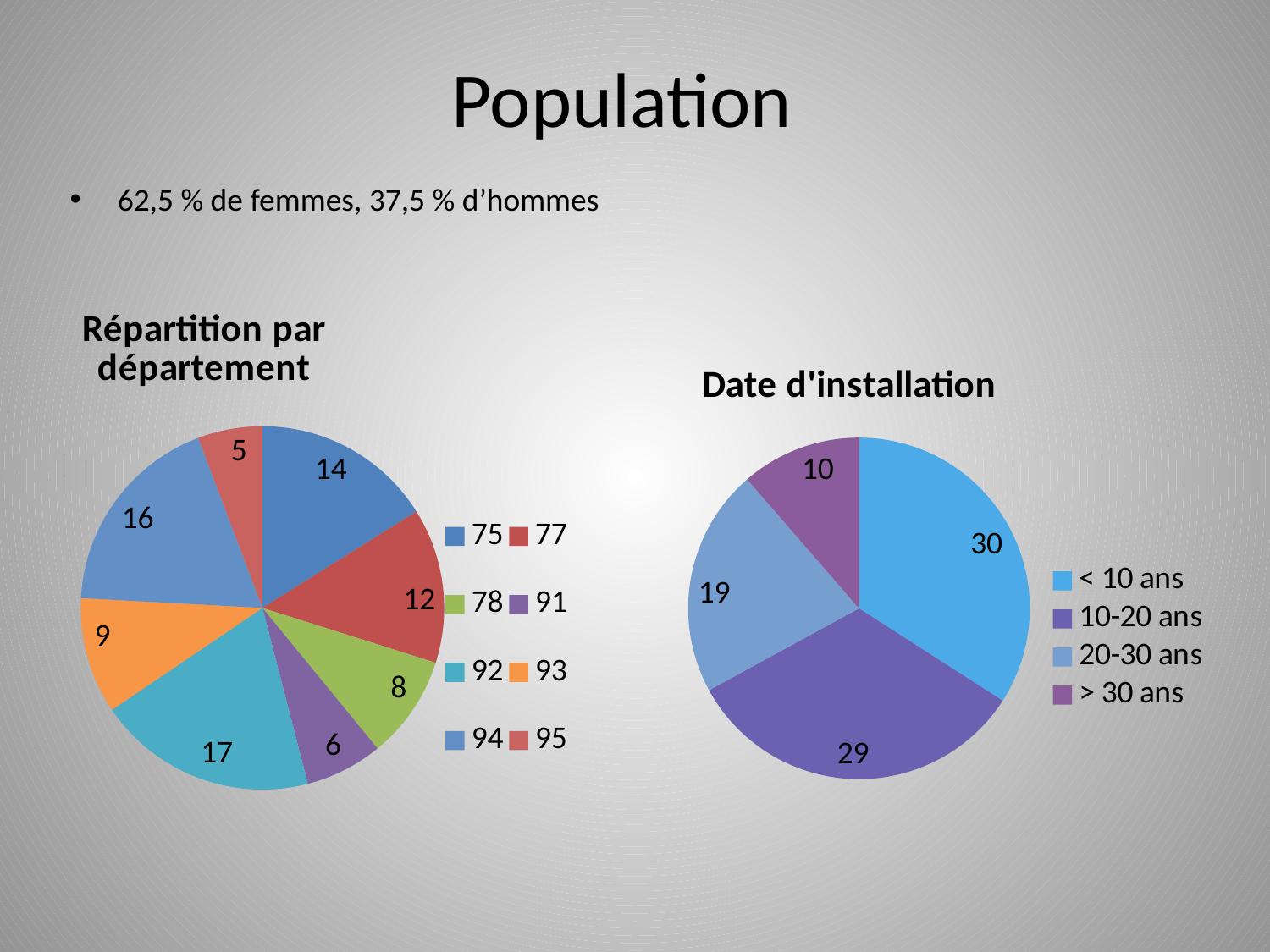
In the 'Répartition par département' chart, which département has the largest slice? 92 In the 'Répartition par département' chart, what is the value for département 95? 5 What type of chart is the 'Date d'installation' chart? Pie chart In the 'Date d'installation' chart, which category has the largest slice? < 10 ans In the 'Répartition par département' chart, what is the difference between the values for 94 and 93? 7 In the 'Répartition par département' chart, which département has the smallest slice? 95 In the 'Date d'installation' chart, which is larger: '10-20 ans' or '20-30 ans'? 10-20 ans In the 'Date d'installation' chart, which category has the smallest slice? > 30 ans In the 'Répartition par département' chart, what is the value for département 92? 17 In the 'Date d'installation' chart, what is the value for '20-30 ans'? 19 In the 'Date d'installation' chart, how many categories does the legend list? 4 In the 'Répartition par département' chart, how many départements are shown? 8